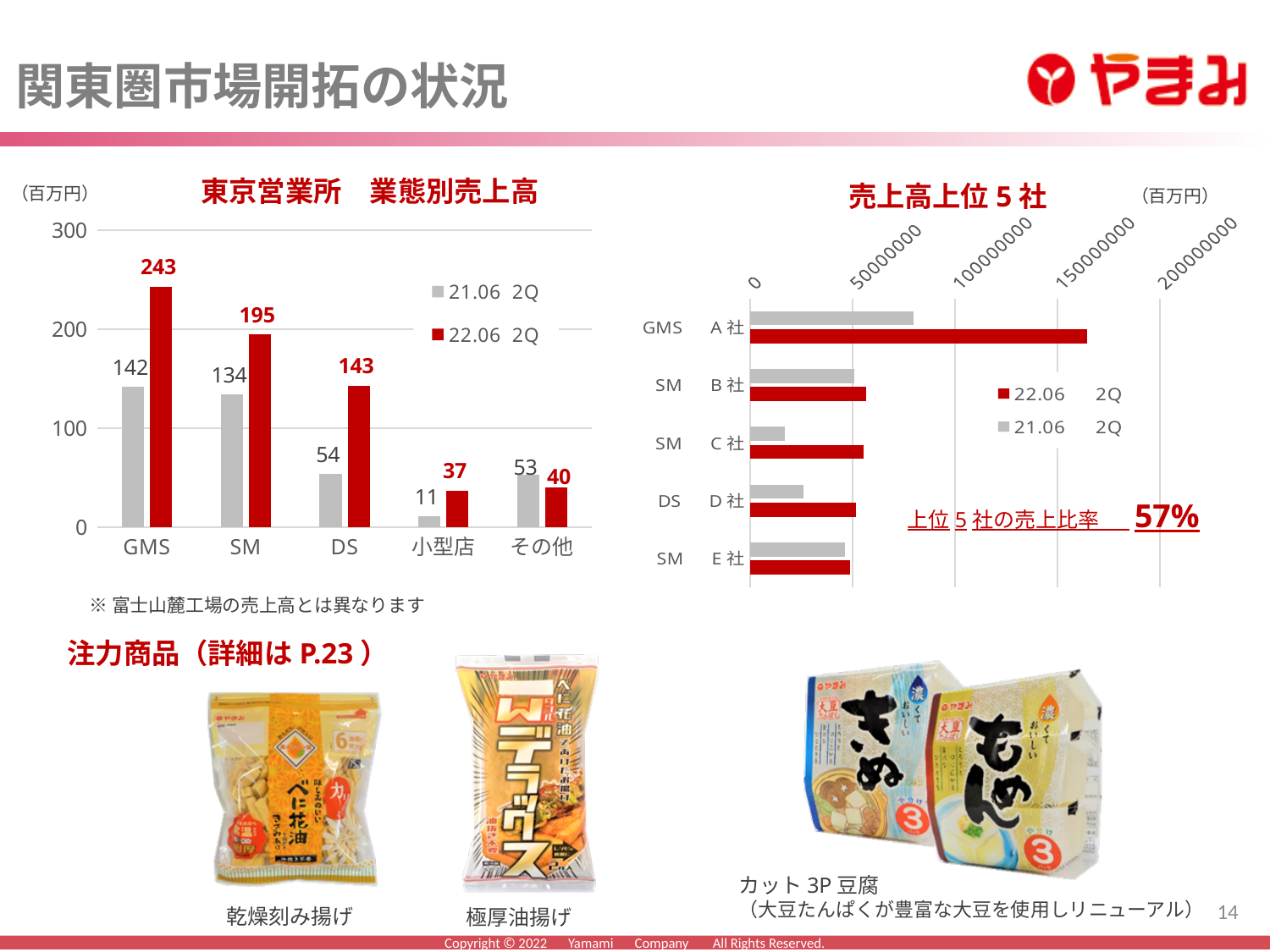
In the 売上高上位5社 chart, which company has the highest 22.06 2Q value? A社 In the 東京営業所 業態別売上高 chart, which category has the highest 22.06 2Q value? GMS How many series does the legend of the 売上高上位5社 chart list? 2 What kind of chart is the 売上高上位5社 chart? Bar chart In the 東京営業所 業態別売上高 chart, for その他, which is larger: the 21.06 2Q value or the 22.06 2Q value? 21.06 2Q How many categories are shown on the x axis of the 東京営業所 業態別売上高 chart? 5 In the 売上高上位5社 chart, is the 22.06 2Q value for A社 greater or less than 150000000? greater In the 東京営業所 業態別売上高 chart, what is the 22.06 2Q value for GMS? 243 In the 東京営業所 業態別売上高 chart, what is the difference between the 22.06 2Q and 21.06 2Q values for DS? 89 In the 東京営業所 業態別売上高 chart, which category has the lowest 21.06 2Q value? 小型店 In the 東京営業所 業態別売上高 chart, what is the 21.06 2Q value for SM? 134 In the 東京営業所 業態別売上高 chart, what is the 22.06 2Q value for 小型店? 37